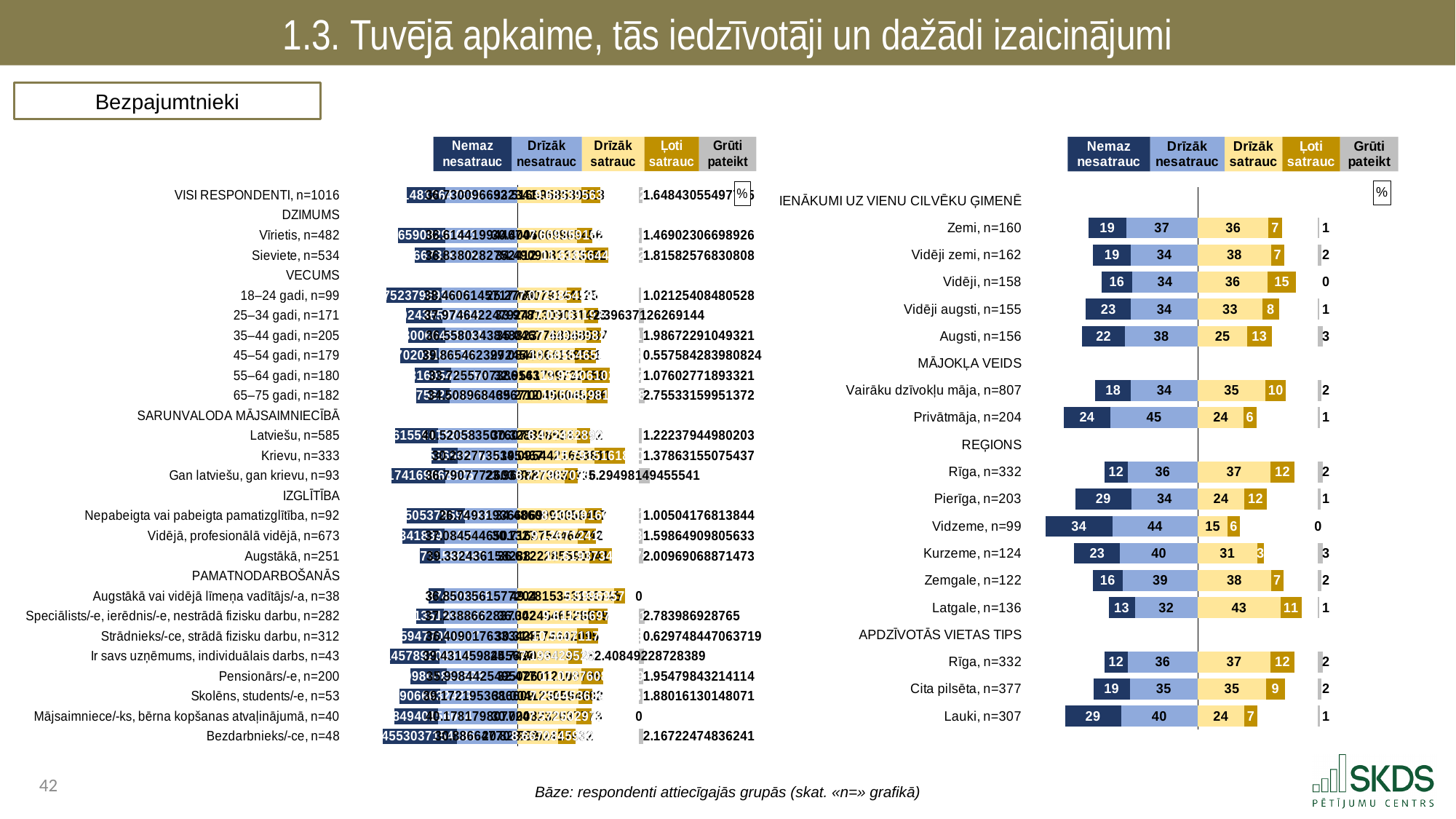
In the right-hand chart, what is the value of "Nemaz nesatrauc" for Privātmāja, n=204? 24 In the right-hand chart, which category has the lowest "Drīzāk satrauc" value? Vidzeme, n=99 What kind of chart is the right-hand chart? Stacked bar chart In the right-hand chart, which category has the highest "Nemaz nesatrauc" value? Vidzeme, n=99 In the right-hand chart, which has the larger "Ļoti satrauc" value: Augsti, n=156 or Zemi, n=160? Augsti, n=156 In the right-hand chart, what is the value of "Drīzāk satrauc" for Latgale, n=136? 43 What is the last legend entry shown above the left-hand chart? Grūti pateikt How many category bars are plotted in the right-hand chart? 16 In the right-hand chart, what is the difference between the "Drīzāk nesatrauc" values for Privātmāja, n=204 and Vairāku dzīvokļu māja, n=807? 11 In the right-hand chart, what is the total of the stacked bar for Privātmāja, n=204? 100 In the right-hand chart, what is the value of "Ļoti satrauc" for Vidēji, n=158? 15 How many series does the legend of the right-hand chart list? 5